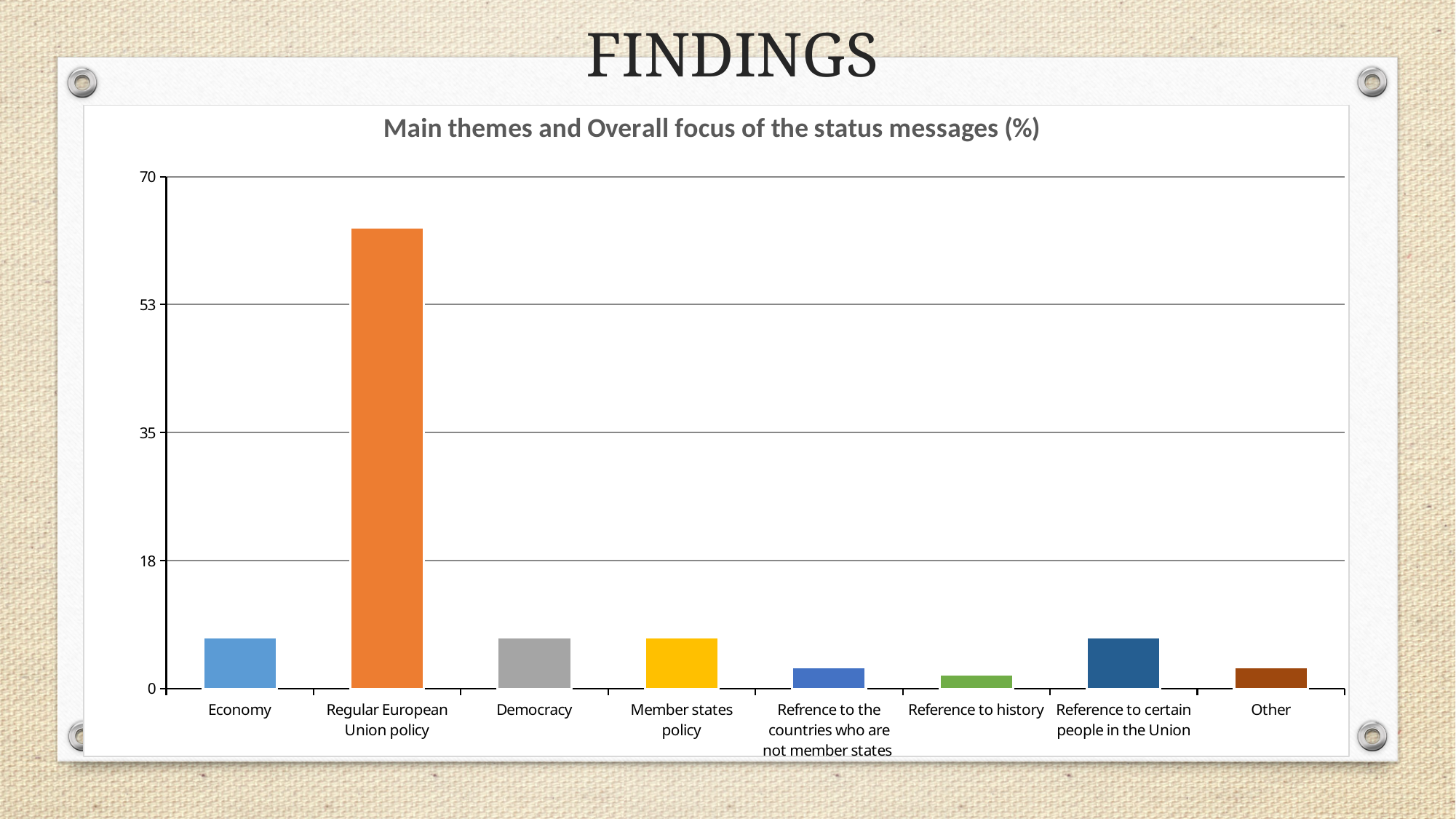
Is the value for Regular European Union policy greater or less than 70? less Is the value for Regular European Union policy greater or less than 53? greater What kind of chart is shown on the slide? bar chart What is the title of the chart? Main themes and Overall focus of the status messages (%) Which is larger, the value for Regular European Union policy or the value for Democracy? Regular European Union policy Which is larger, the value for Reference to certain people in the Union or the value for Other? Reference to certain people in the Union Is the value for Reference to history greater or less than 18? less Which is larger, the value for Economy or the value for Reference to history? Economy Which category has the highest value in the chart? Regular European Union policy How many categories are shown on the x axis of the chart? 8 What colour is the bar for Regular European Union policy? orange